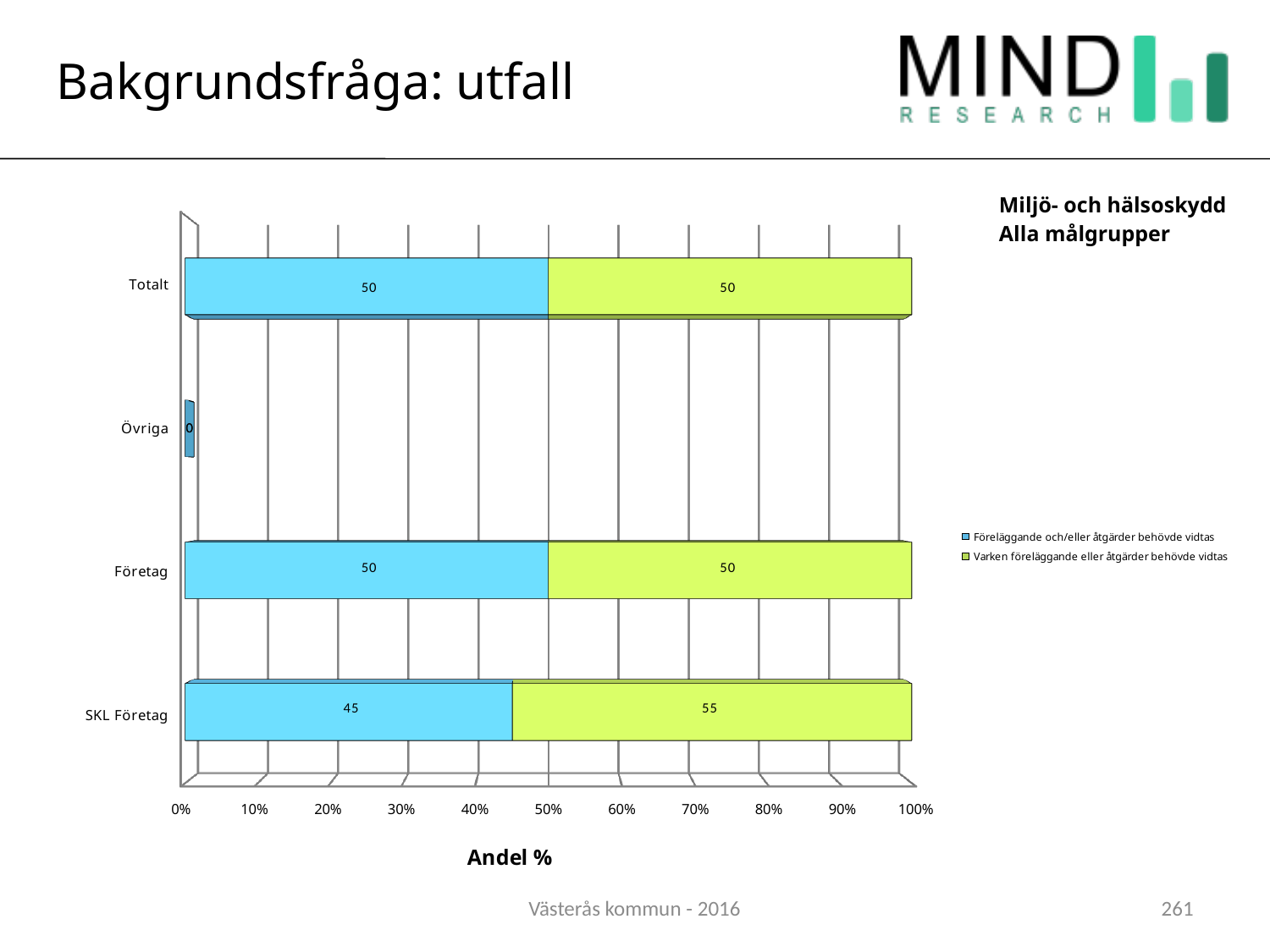
For SKL Företag, which is larger: 'Föreläggande och/eller åtgärder behövde vidtas' or 'Varken föreläggande eller åtgärder behövde vidtas'? Varken föreläggande eller åtgärder behövde vidtas Which category has the lowest value for 'Föreläggande och/eller åtgärder behövde vidtas'? Övriga What is the difference between the two series values for SKL Företag? 10 What value is labelled on the bar for Övriga? 0 What is the value of 'Föreläggande och/eller åtgärder behövde vidtas' for Totalt? 50 What kind of chart is shown on the slide? bar chart What is the value of 'Varken föreläggande eller åtgärder behövde vidtas' for Företag? 50 What is the value of 'Varken föreläggande eller åtgärder behövde vidtas' for SKL Företag? 55 What is the label of the horizontal axis of the chart? Andel % How many categories are shown on the vertical axis of the chart? 4 How many series does the chart legend list? 2 What is the value of 'Föreläggande och/eller åtgärder behövde vidtas' for SKL Företag? 45